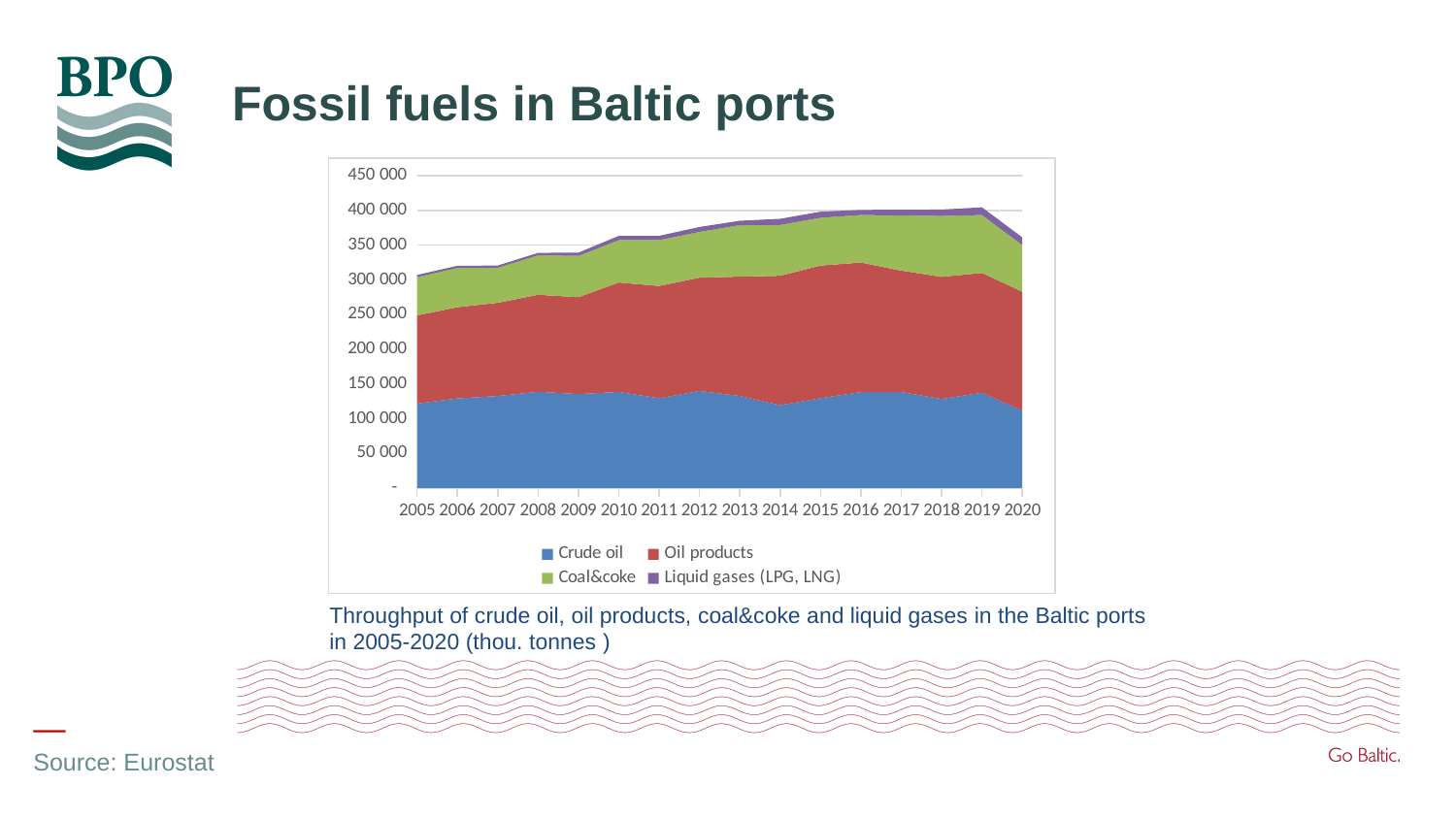
Is the total throughput larger in 2005 or in 2020? 2020 Which series is shown in purple in the legend? Liquid gases (LPG, LNG) Which year has the lowest total throughput? 2005 How many years are shown along the x axis? 16 Which years does the x axis cover, from first to last? 2005 to 2020 Is the total throughput in 2020 greater or less than 400 000? less Is the crude oil value in 2020 greater or less than 150 000? less How many series does the legend list? 4 Does the total throughput rise or fall from 2019 to 2020? fall Is the total throughput in 2020 greater or less than 300 000? greater What kind of chart is shown on the slide? Stacked area chart